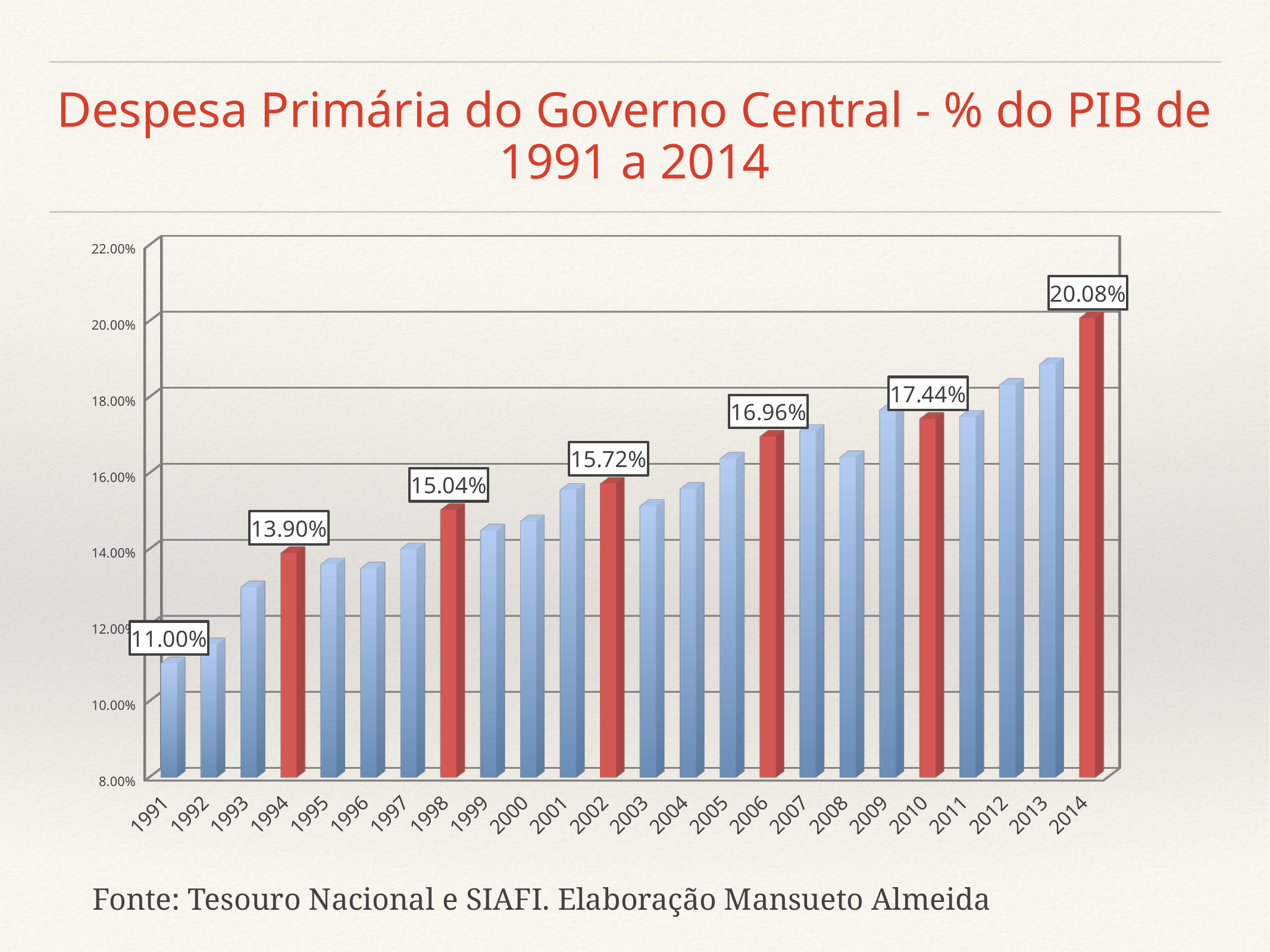
What is the value for 1998? 15.04% What is the value for 2006? 16.96% What is the value for 1991? 11.00% What is the value for 2014? 20.08% Is the value for 1993 greater or less than 14.00%? less Which year has the highest value? 2014 Which is larger, the value for 2002 or the value for 1994? 2002 Which year has the lowest value? 1991 Do the values generally rise or fall from 1991 to 2014? rise Is the value for 2013 greater or less than 18.00%? greater How many years are shown on the x axis? 24 What is the difference between the values for 2014 and 1991? 9.08 percentage points